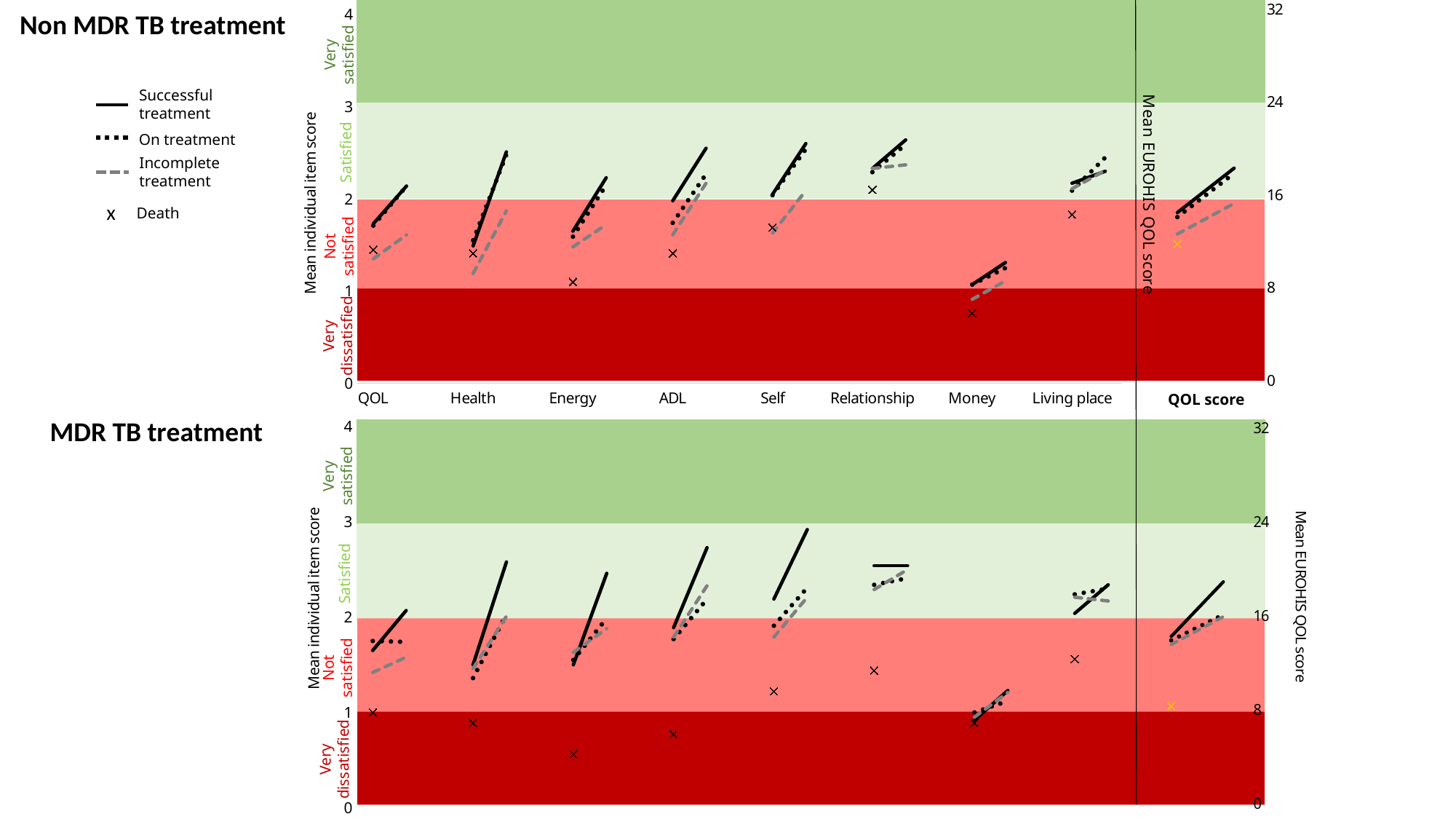
What kind of chart is the 'Non MDR TB treatment' chart? line chart In the 'MDR TB treatment' chart, which category has the lowest Death value? Energy In the 'Non MDR TB treatment' chart, does the Successful treatment line for Health rise or fall from left to right? rise What is the label of the left vertical axis on the 'MDR TB treatment' chart? Mean individual item score In the 'Non MDR TB treatment' chart, is the Death value for Money greater or less than 1? less In the 'MDR TB treatment' chart, is the Death value for Living place greater or less than 1? greater How many entries does the legend list for the charts? 4 What is the label of the right vertical axis on the 'MDR TB treatment' chart? Mean EUROHIS QOL score In the 'Non MDR TB treatment' chart, is the Death value for Living place greater or less than 2? less In the 'MDR TB treatment' chart, which is higher: the Death value for Self or the Death value for Money? Self In the 'Non MDR TB treatment' chart, which category has the highest Death value? Relationship